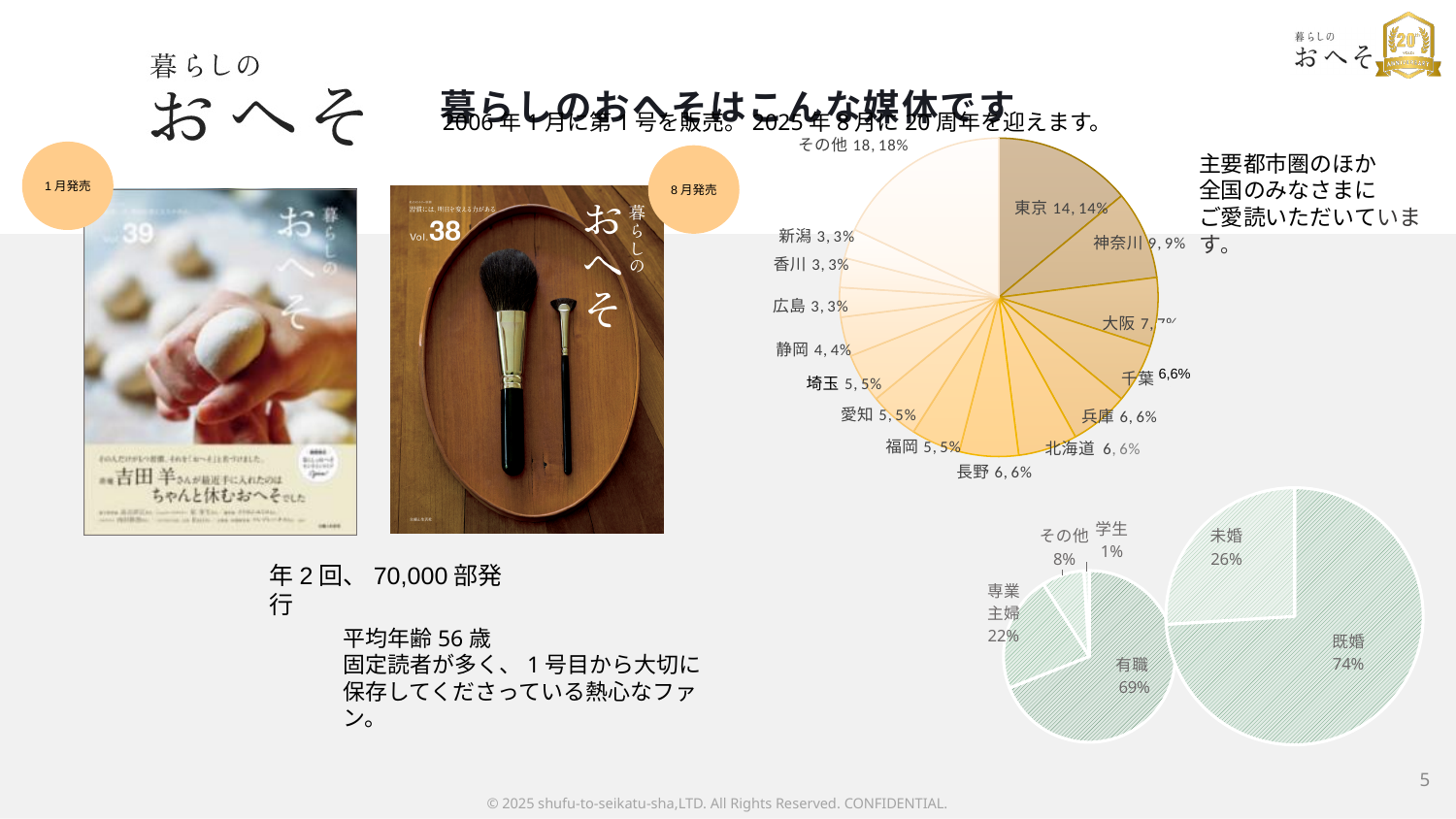
How many slices does the marital status pie chart at the bottom right of the slide have? 2 In the large pie chart at the top right of the slide, which is larger, 東京 or 神奈川? 東京 In the occupation pie chart at the bottom of the slide, which category has the smallest share? 学生 In the occupation pie chart at the bottom of the slide, what is the difference in percentage points between 有職 and 専業主婦? 47 In the large pie chart at the top right of the slide, which labelled slice has the largest share? その他 In the marital status pie chart at the bottom right of the slide, what percentage is shown for 既婚? 74% In the large pie chart at the top right of the slide, what is the difference in percentage points between 東京 and 静岡? 10 In the large pie chart at the top right of the slide, what percentage is shown for 東京? 14% In the large pie chart at the top right of the slide, what percentage is shown for 神奈川? 9% In the occupation pie chart at the bottom of the slide, what percentage is shown for 有職? 69% How many slices does the large pie chart at the top right of the slide have? 15 What kind of chart is the large chart at the top right of the slide? Pie chart